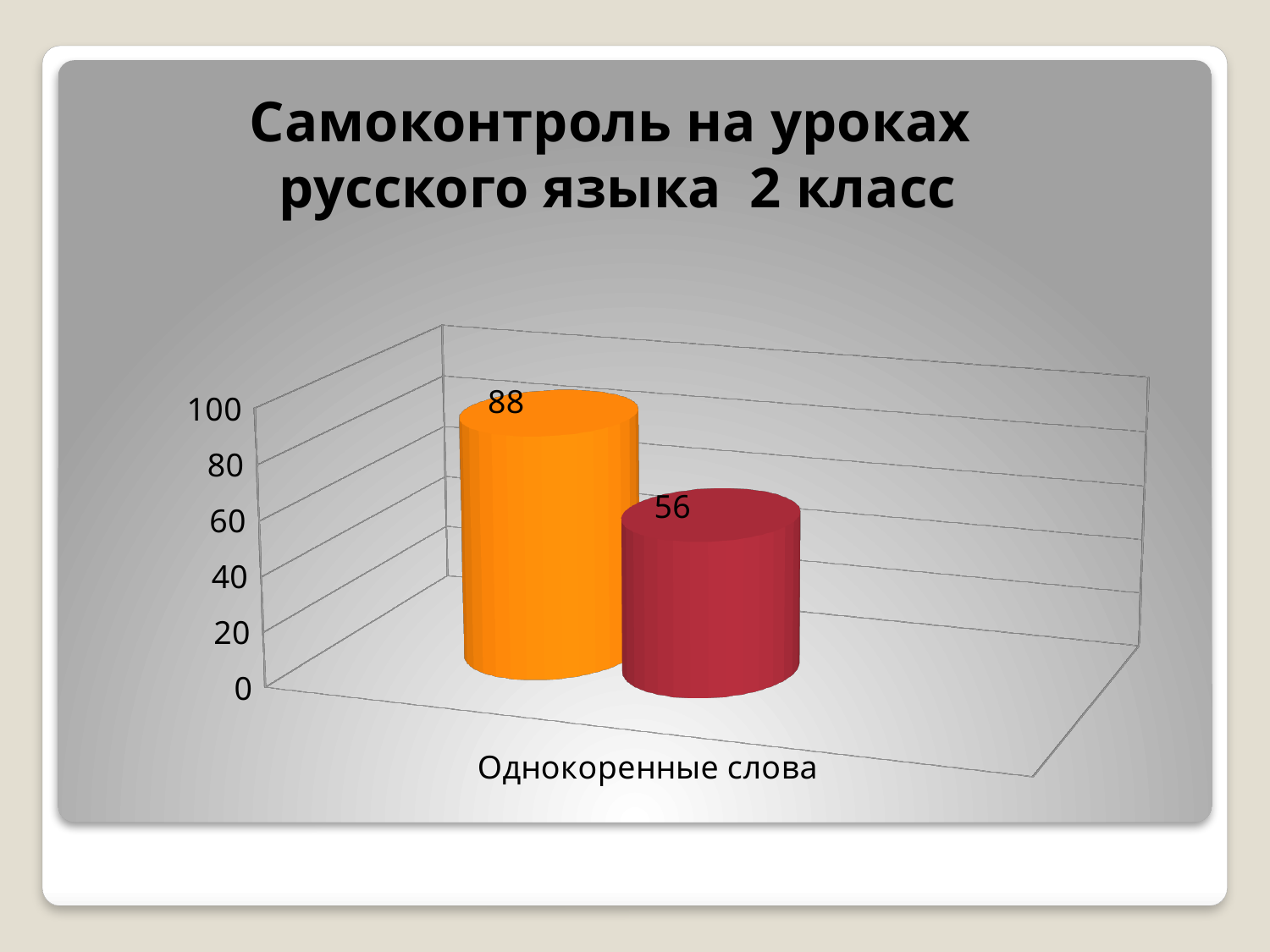
What is the difference between the orange bar's value and the red bar's value? 32 What kind of chart is shown on the slide? bar chart How many categories are shown on the x axis of the chart? 1 What is the category label shown on the x axis of the chart? Однокоренные слова What is the value shown on the red bar? 56 What is the title of the slide? Самоконтроль на уроках русского языка 2 класс What is the lowest value plotted on the chart? 56 What is the highest value plotted on the chart? 88 Is the value of the orange bar greater or less than 80? greater Which bar has the higher value, the orange one or the red one? the orange one What is the value shown on the orange bar? 88 Is the value of the red bar greater or less than 60? less